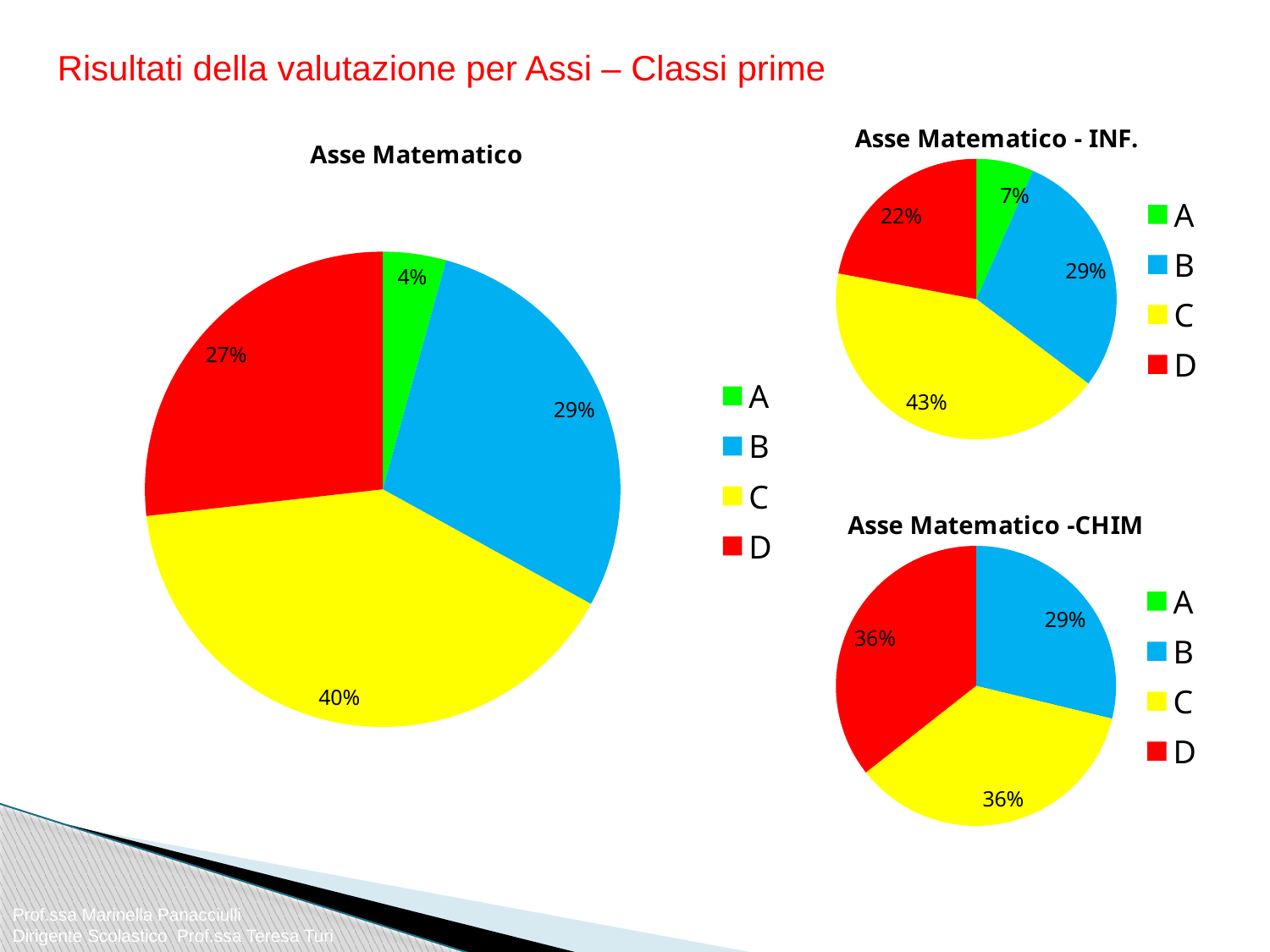
In the 'Asse Matematico' chart, which category has the smallest slice? A In the 'Asse Matematico' chart, what is the share for category C? 40% In the 'Asse Matematico -CHIM' chart, what is the share for category D? 36% In the 'Asse Matematico - INF.' chart, which category has the largest slice? C In the 'Asse Matematico' chart, which category has the largest slice? C In the 'Asse Matematico' chart, what is the difference between the shares of C and D? 13% In the 'Asse Matematico - INF.' chart, which is larger, the share for B or the share for D? B In the 'Asse Matematico -CHIM' chart, what is the share for category B? 29% In the 'Asse Matematico' chart, what is the share for category A? 4% What kind of chart is the 'Asse Matematico' chart? Pie chart In the 'Asse Matematico - INF.' chart, what is the share for category D? 22% How many entries does the legend of the 'Asse Matematico - INF.' chart list? 4